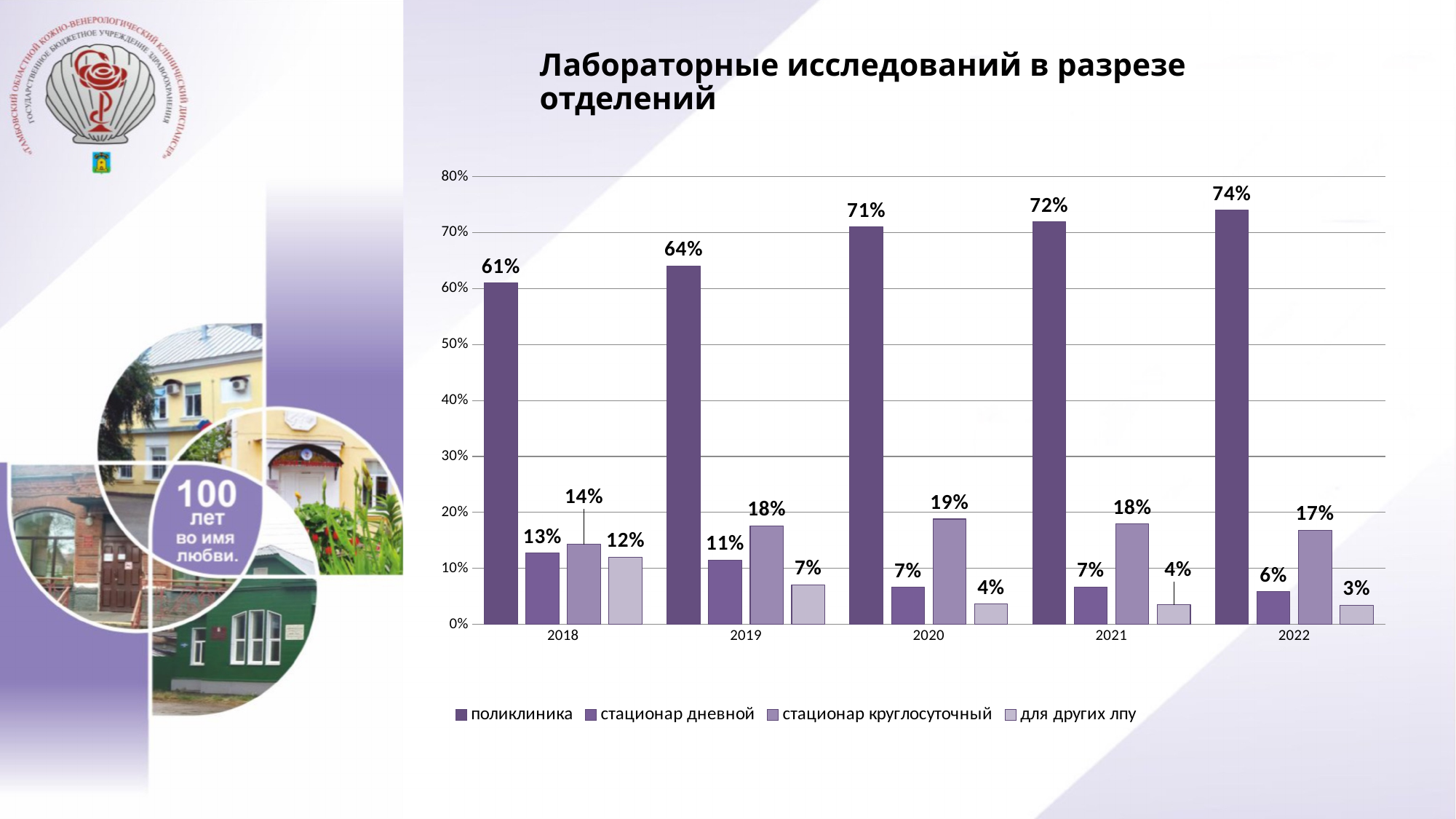
What is the value for стационар круглосуточный in 2020? 19% What kind of chart is shown on the slide? bar chart What is the value for поликлиника in 2022? 74% What is the value for для других лпу in 2018? 12% Does the value for поликлиника rise or fall from 2018 to 2022? rise How many series does the legend list? 4 Which is larger in 2021: стационар дневной or стационар круглосуточный? стационар круглосуточный In which year is the value for для других лпу the highest? 2018 What is the difference between the поликлиника values in 2022 and 2018? 13% In which year is the value for поликлиника the lowest? 2018 What is the value for стационар дневной in 2019? 11% How many years are shown on the x axis? 5